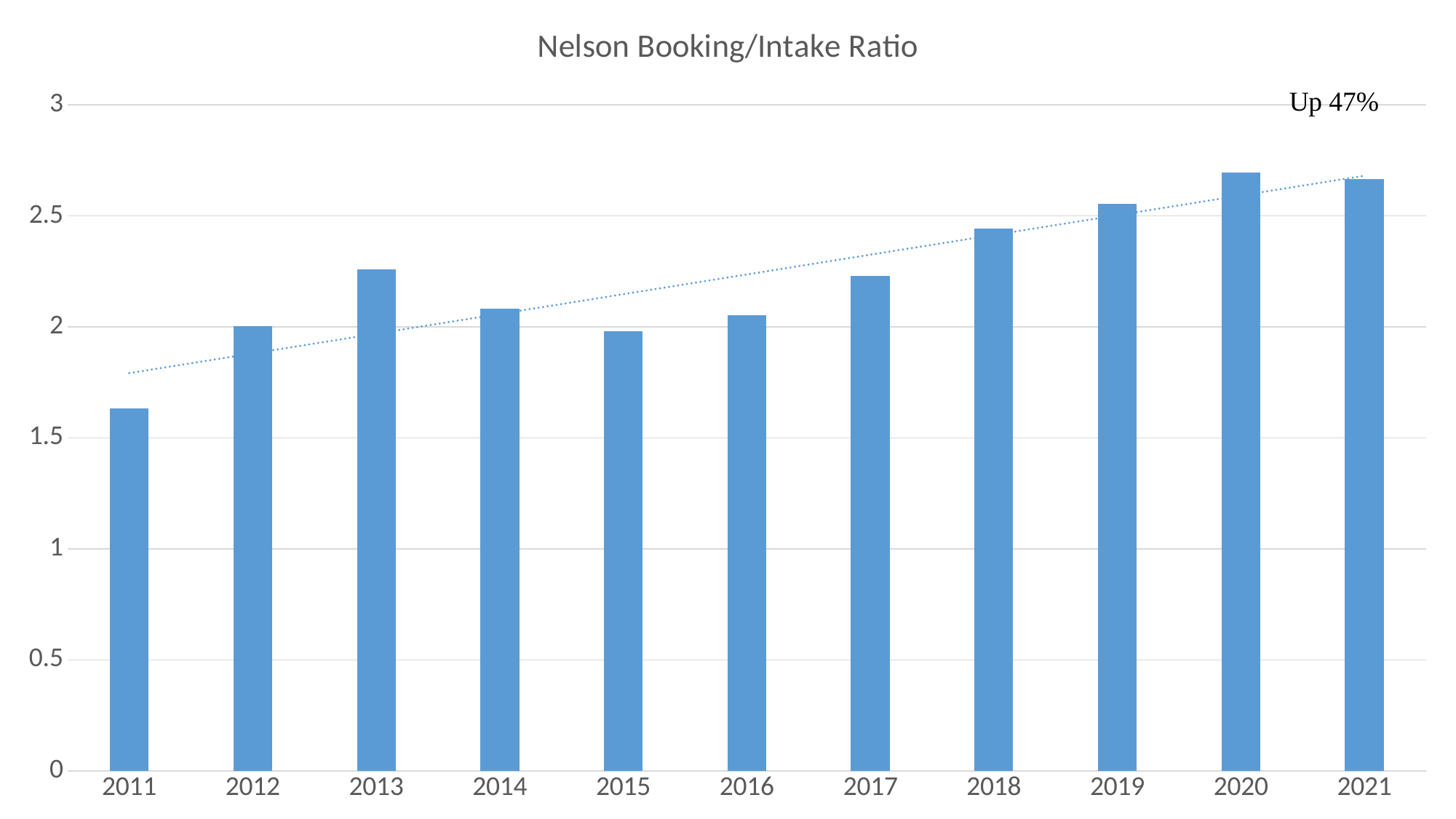
Which year has the highest booking/intake ratio? 2020 Is the value for 2019 greater or less than 2.5? greater Do the values generally rise or fall from 2011 to 2021? Rise Is the value for 2011 greater or less than 2? less How many years are shown on the x axis of the chart? 11 What is the title of the chart? Nelson Booking/Intake Ratio What percentage change is annotated in the top right of the chart? Up 47% Which year has the larger value, 2013 or 2014? 2013 Is the value for 2013 greater or less than 2? greater Which year has the lowest booking/intake ratio? 2011 What kind of chart is shown on the slide? Bar chart